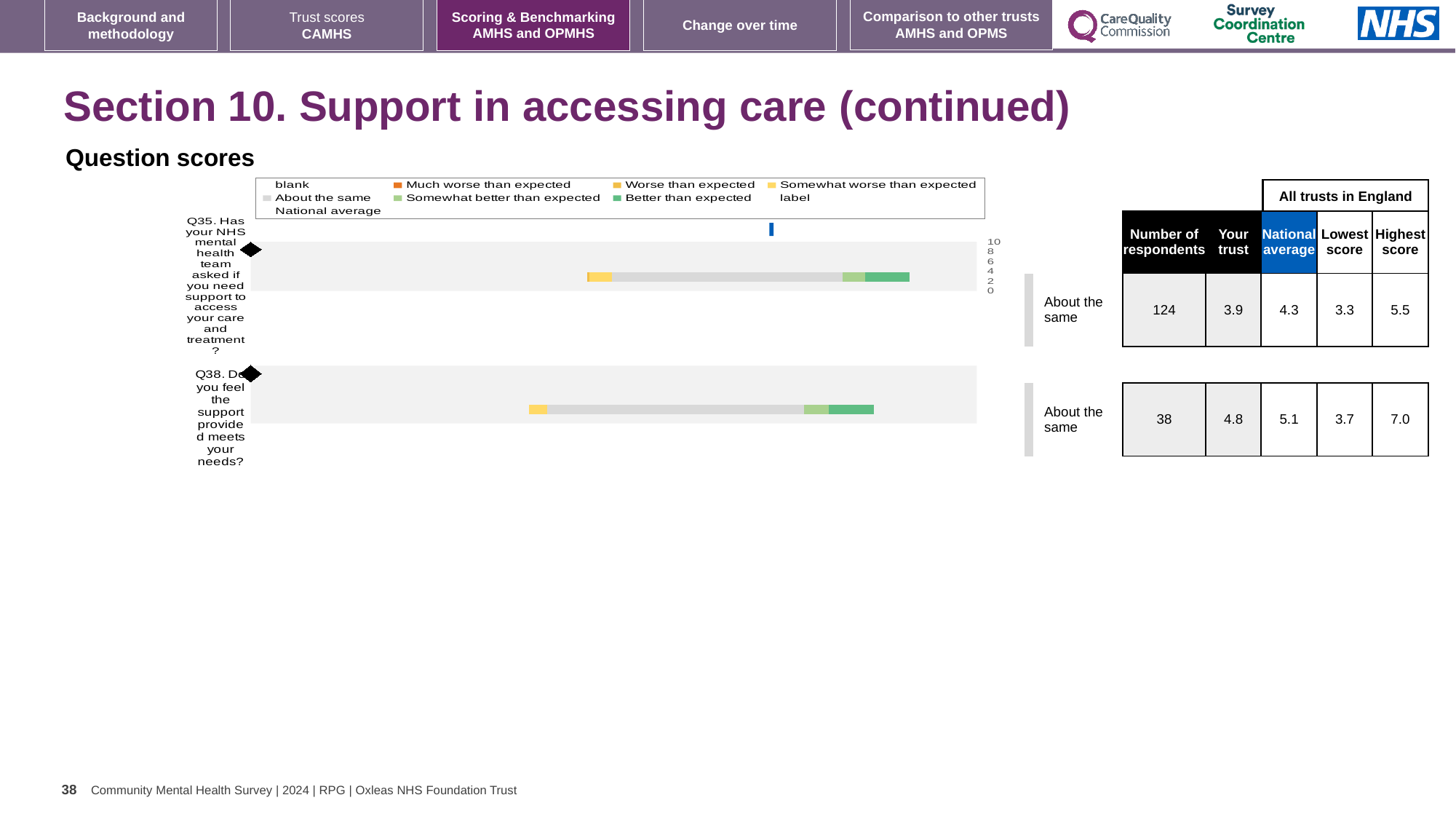
How many questions (categories) are plotted in the chart? 2 In the chart legend, what colour represents 'About the same'? grey In the table beside the chart, what is the highest score for Q38? 7.0 What kind of chart is shown under 'Question scores'? bar chart In the table beside the chart, what is the lowest score for Q35? 3.3 What benchmark category is shown next to the Q38 bar? About the same In the table beside the chart, what is the national average for Q38? 5.1 In the chart legend, what colour represents 'Better than expected'? green What is the difference between the national average and the 'Your trust' score for Q38 in the table? 0.3 In the table beside the chart, what is the 'Your trust' score for Q35? 3.9 In the table beside the chart, what is the number of respondents for Q35? 124 Which question has more respondents in the table, Q35 or Q38? Q35